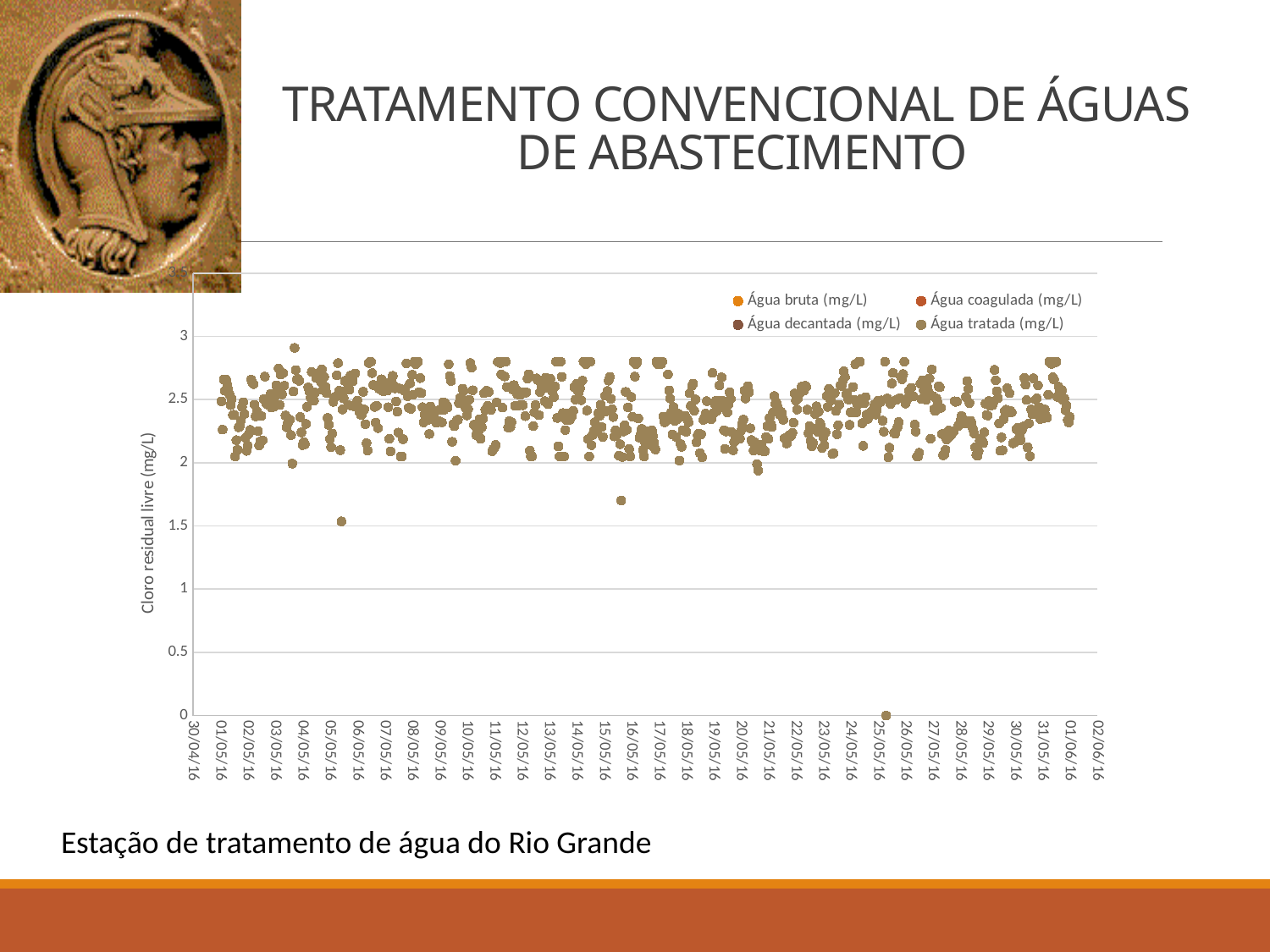
Are the bulk of the plotted points greater or less than 3? less Are the bulk of the plotted points greater or less than 2? greater Do the plotted values show a clear rising or falling trend across the dates on the x axis, or do they stay roughly level? roughly level Is the isolated low point plotted near 05/05/16 greater or less than 1? greater Which of the two isolated low points is lower: the one near 05/05/16 or the one near 15/05/16? the one near 05/05/16 How many series does the chart legend list? 4 Which series is listed last in the chart legend? Água tratada (mg/L) What is the label of the vertical axis of the chart? Cloro residual livre (mg/L) What kind of chart is shown on the slide? scatter chart